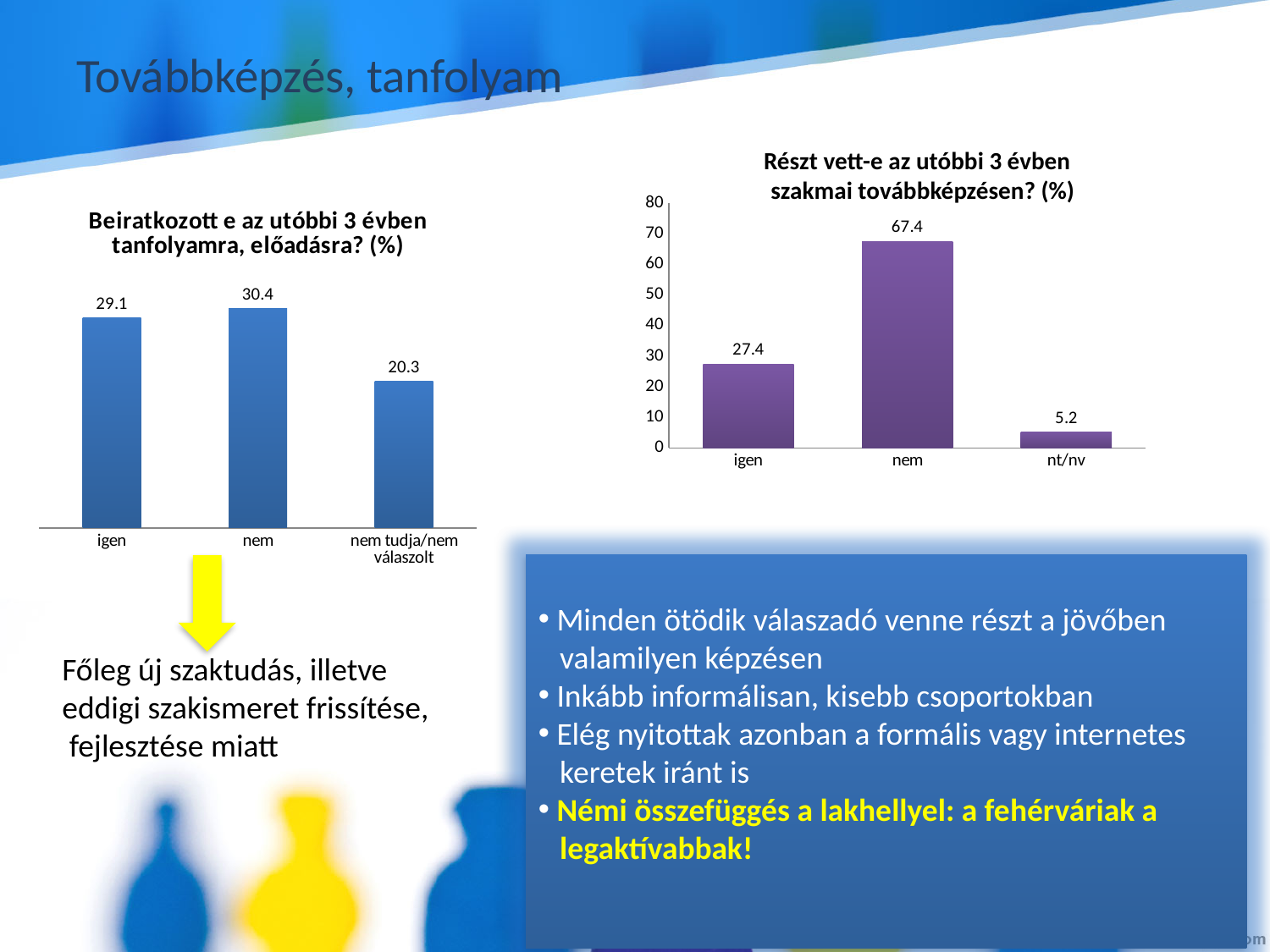
In the chart titled "Beiratkozott e az utóbbi 3 évben tanfolyamra, előadásra? (%)", how many categories are shown? 3 In the chart titled "Beiratkozott e az utóbbi 3 évben tanfolyamra, előadásra? (%)", what is the value for "igen"? 29.1 In the chart titled "Részt vett-e az utóbbi 3 évben szakmai továbbképzésen? (%)", what is the value for "nem"? 67.4 In the chart titled "Részt vett-e az utóbbi 3 évben szakmai továbbképzésen? (%)", which category has the highest value? nem In the chart titled "Beiratkozott e az utóbbi 3 évben tanfolyamra, előadásra? (%)", what is the difference between the values for "nem" and "igen"? 1.3 In the chart titled "Beiratkozott e az utóbbi 3 évben tanfolyamra, előadásra? (%)", which category has the lowest value? nem tudja/nem válaszolt In the chart titled "Részt vett-e az utóbbi 3 évben szakmai továbbképzésen? (%)", what is the difference between the values for "nem" and "igen"? 40 In the chart titled "Részt vett-e az utóbbi 3 évben szakmai továbbképzésen? (%)", is the value for "igen" greater or less than 30? less What kind of chart is the chart titled "Részt vett-e az utóbbi 3 évben szakmai továbbképzésen? (%)"? bar chart In the chart titled "Részt vett-e az utóbbi 3 évben szakmai továbbképzésen? (%)", which is larger, the value for "igen" or the value for "nt/nv"? igen In the chart titled "Részt vett-e az utóbbi 3 évben szakmai továbbképzésen? (%)", what is the value for "nt/nv"? 5.2 In the chart titled "Beiratkozott e az utóbbi 3 évben tanfolyamra, előadásra? (%)", what is the value for "nem tudja/nem válaszolt"? 20.3